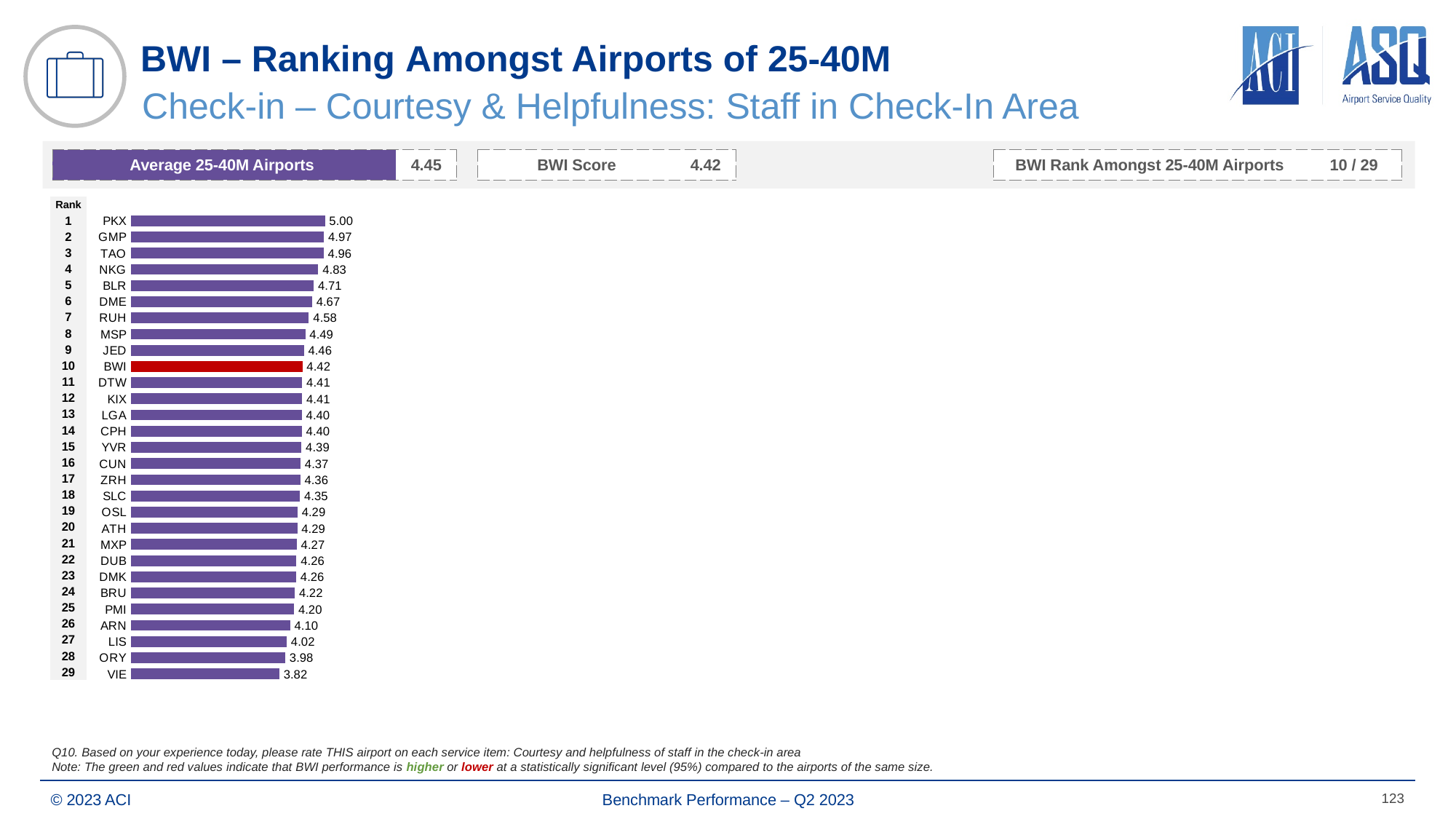
What is the difference between the scores of PKX and VIE? 1.18 What kind of chart is shown on the slide? Bar chart What is the difference between the scores of JED and BWI? 0.04 What is the score for PKX? 5.00 Which has a higher score, DME or ARN? DME What is the score for MSP? 4.49 Which airport has the lowest score in the chart? VIE Which bar in the chart is coloured red? BWI What is the score for BWI in the chart? 4.42 How many airports are ranked in the chart? 29 Which airport has the highest score in the chart? PKX What is the score for VIE? 3.82